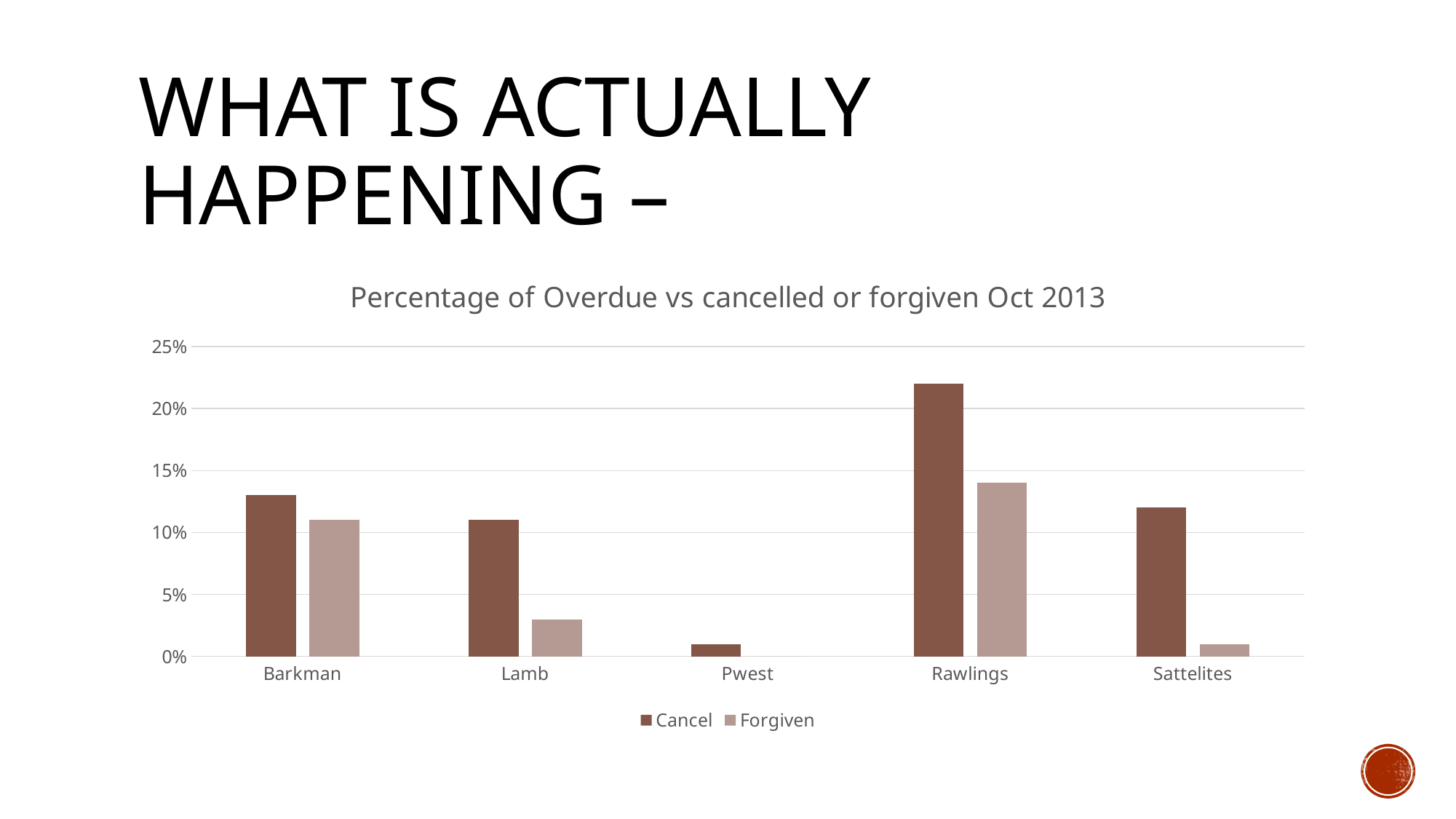
Which category has the highest Cancel value? Rawlings Which category has the lowest Cancel value? Pwest How many series does the legend list? 2 Is the Cancel value for Rawlings greater or less than 20%? greater What kind of chart is shown on the slide? Bar chart How many categories are shown on the x axis? 5 What is the title of the chart? Percentage of Overdue vs cancelled or forgiven Oct 2013 Is the Forgiven value for Lamb greater or less than 5%? less Which is larger: the Forgiven value for Barkman or the Forgiven value for Rawlings? Rawlings Is the Cancel value for Barkman greater or less than 10%? greater For Lamb, which is larger: the Cancel value or the Forgiven value? Cancel Which category has the highest Forgiven value? Rawlings